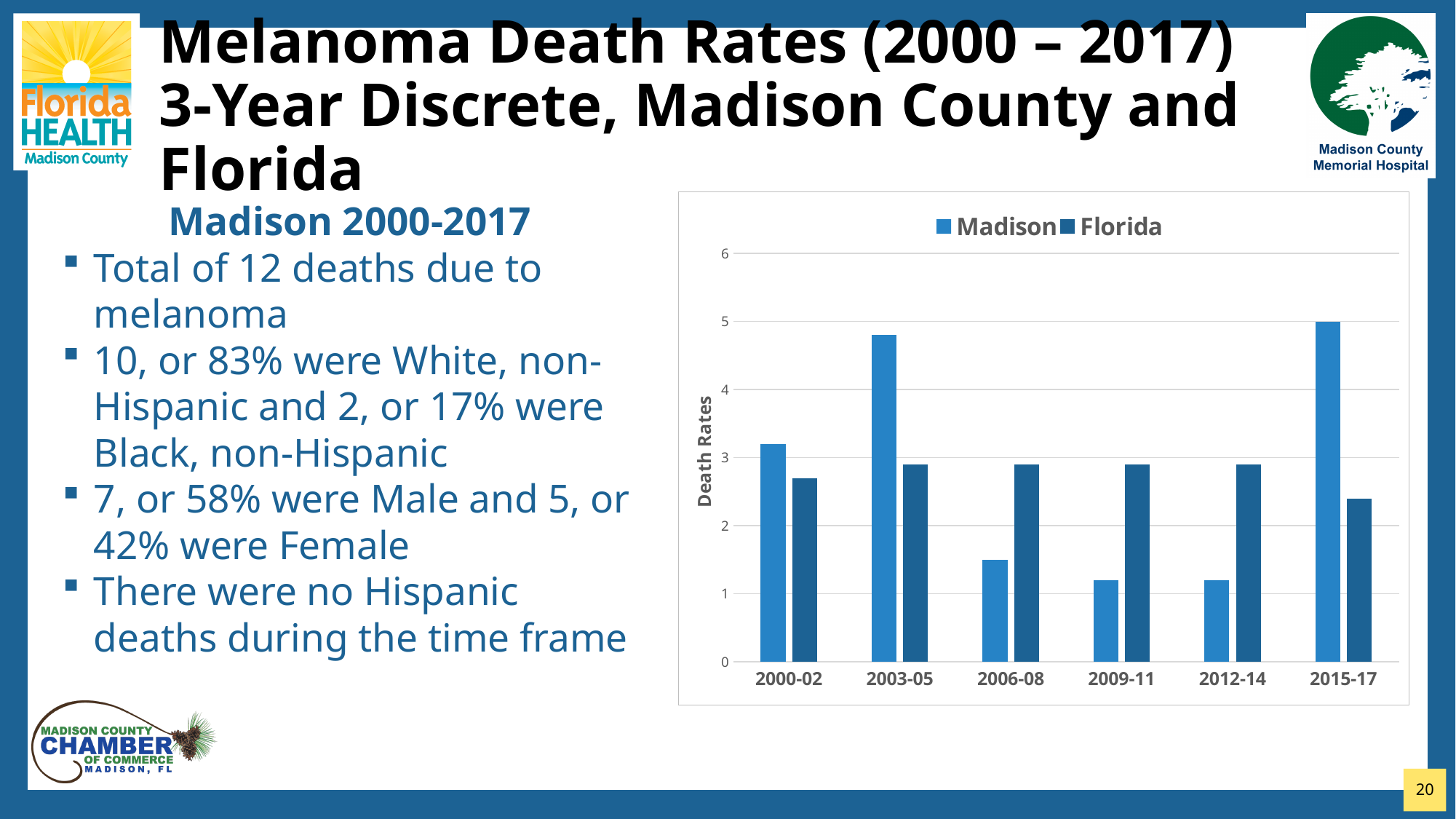
Is the Madison value for 2000-02 greater or less than 3? greater Which series is shown in the lighter blue bars? Madison In 2006-08, which is larger, the Madison value or the Florida value? Florida In which period is the Florida death rate lowest? 2015-17 Is the Madison value for 2006-08 greater or less than 2? less What is the label of the vertical axis? Death Rates How many time periods are shown on the x axis of the chart? 6 How many series does the chart legend list? 2 What kind of chart is shown on the slide? bar chart In 2003-05, which is larger, the Madison value or the Florida value? Madison Is the Madison value for 2003-05 greater or less than 4? greater